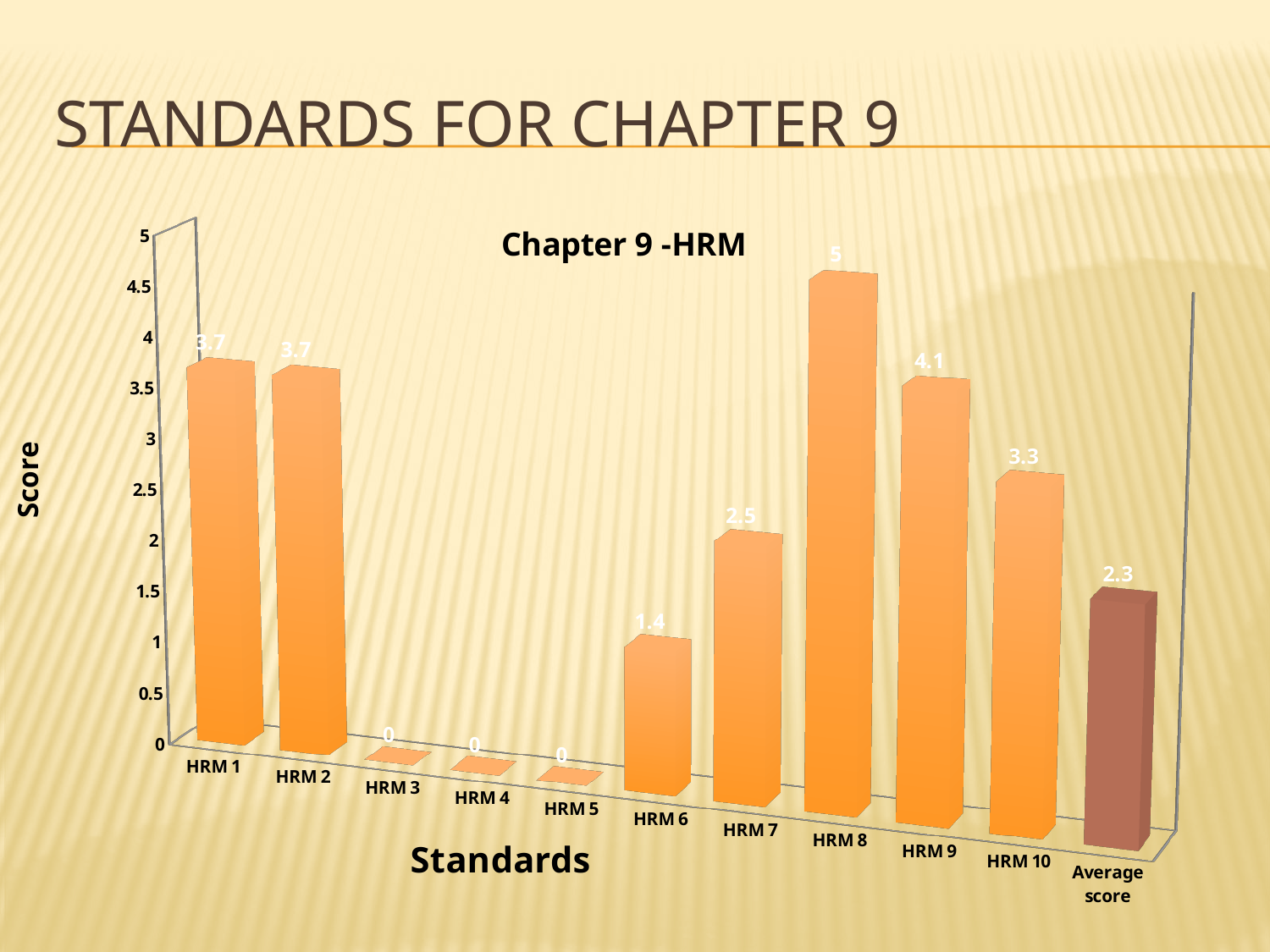
What type of chart is shown on the slide? bar chart Is the score for HRM 9 greater or less than 4? greater How many bars are plotted in the chart? 11 What is the title of the chart? Chapter 9 -HRM What is the difference between the scores for HRM 9 and HRM 10? 0.8 What is the value of the Average score bar? 2.3 Which standard has the highest score? HRM 8 Which has a higher score, HRM 7 or HRM 10? HRM 10 What is the score for HRM 8? 5 How many standards have a score of 0? 3 What is the label of the vertical axis? Score What is the score for HRM 6? 1.4